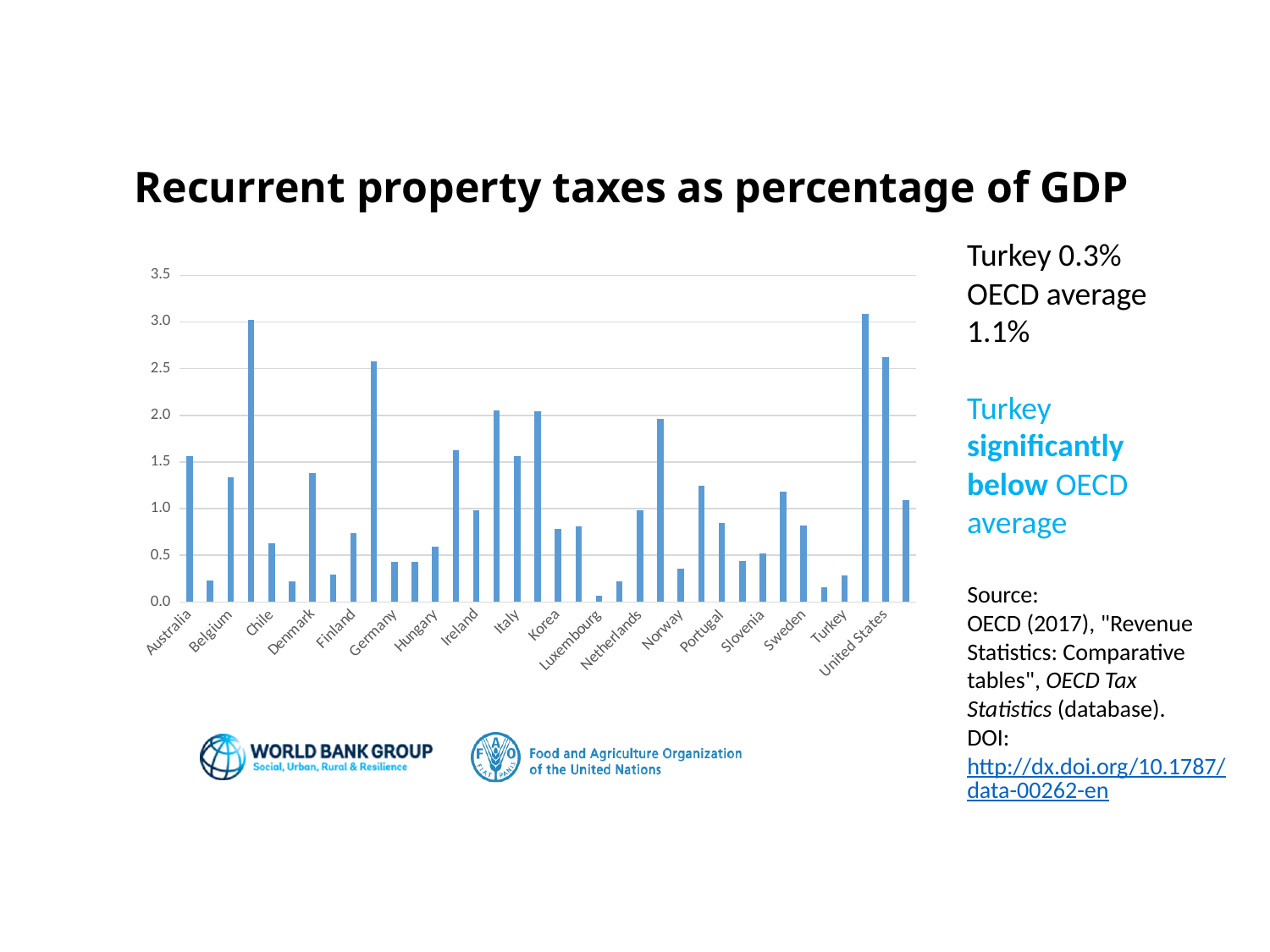
Which labelled country has the lowest bar in the chart? Luxembourg Is the value for United States greater or less than 2.5? greater Is the value for Australia greater or less than 1.0? greater Which has the larger value, United States or Australia? United States Is the value for Chile greater or less than 1.0? less Which has the larger value, Italy or Korea? Italy What kind of chart is shown on the slide? bar chart Which has the larger value, Belgium or Chile? Belgium What is the title of the slide's chart? Recurrent property taxes as percentage of GDP According to the text beside the chart, what is the OECD average for recurrent property taxes as a percentage of GDP? 1.1%